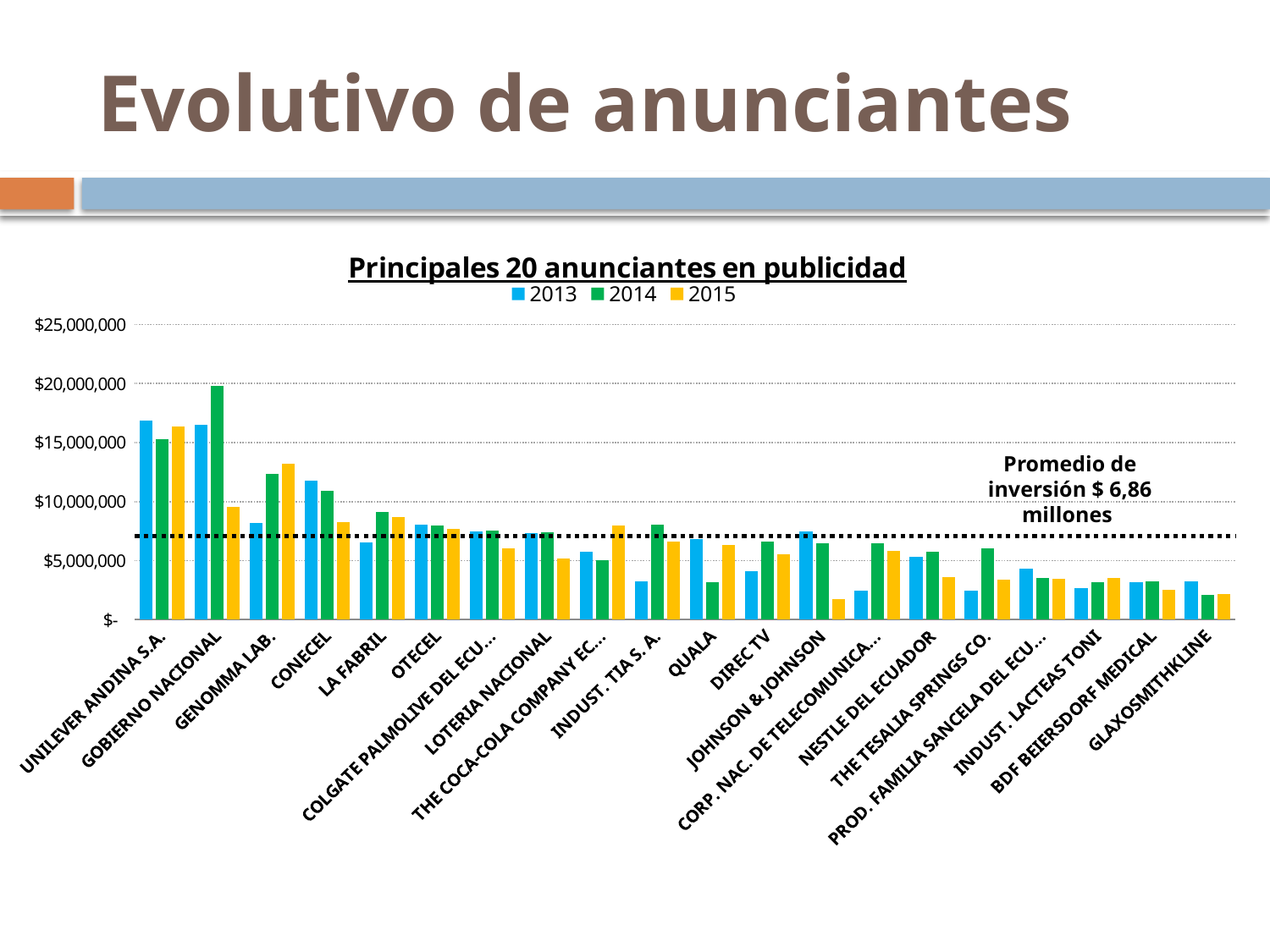
How many series does the legend of the chart list? 3 Which advertiser has the tallest bar in the chart? GOBIERNO NACIONAL Do the values generally rise or fall moving from left to right along the x axis? Fall For GOBIERNO NACIONAL, which year has the highest bar? 2014 How many advertisers (categories) are shown on the x axis of the chart? 20 What average investment does the dotted line annotation on the chart indicate? $ 6,86 millones Is the 2014 value for GOBIERNO NACIONAL greater or less than $15,000,000? greater Is the 2015 value for GENOMMA LAB. greater or less than $10,000,000? greater Is the 2015 value for JOHNSON & JOHNSON greater or less than $5,000,000? less What kind of chart is shown on the slide? Bar chart For UNILEVER ANDINA S.A., which is larger: the 2013 value or the 2014 value? 2013 For GENOMMA LAB., which year has the highest bar? 2015